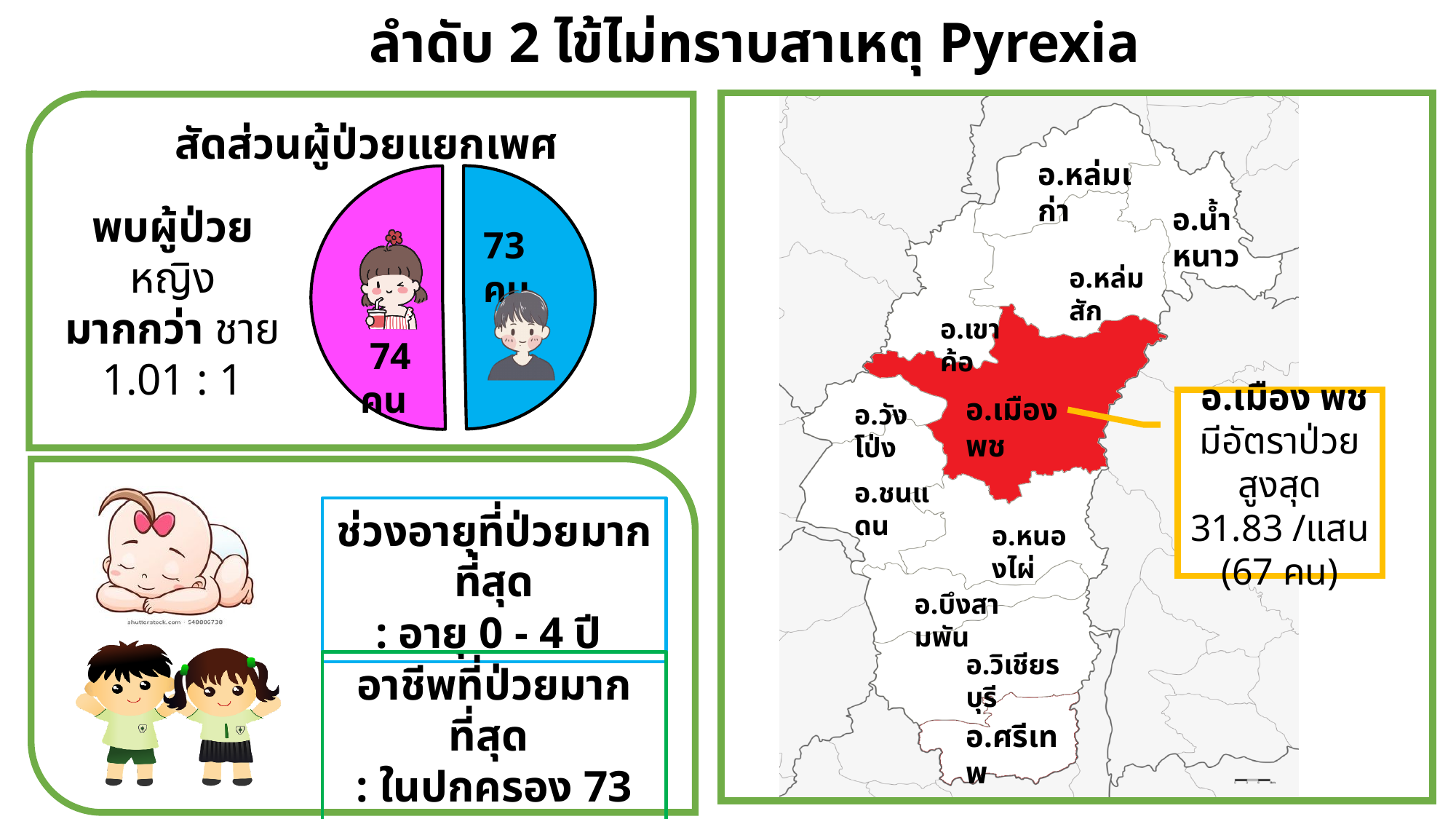
In the pie chart สัดส่วนผู้ป่วยแยกเพศ, which slice is larger, female (หญิง) or male (ชาย)? female (หญิง) What colour is the female (หญิง) slice in the pie chart สัดส่วนผู้ป่วยแยกเพศ? pink In the pie chart สัดส่วนผู้ป่วยแยกเพศ, how many patients are male (ชาย)? 73 คน How many slices does the pie chart สัดส่วนผู้ป่วยแยกเพศ have? 2 In the pie chart สัดส่วนผู้ป่วยแยกเพศ, how many patients are female (หญิง)? 74 คน Which group has the highest patient count in the pie chart สัดส่วนผู้ป่วยแยกเพศ? หญิง (female) Which group has the lowest patient count in the pie chart สัดส่วนผู้ป่วยแยกเพศ? ชาย (male) What kind of chart is shown under the title สัดส่วนผู้ป่วยแยกเพศ? pie chart What is the total number of patients across both slices of the pie chart สัดส่วนผู้ป่วยแยกเพศ? 147 คน What is the title of the pie chart on the left of the slide? สัดส่วนผู้ป่วยแยกเพศ In the pie chart สัดส่วนผู้ป่วยแยกเพศ, what is the difference between the female and male patient counts? 1 คน